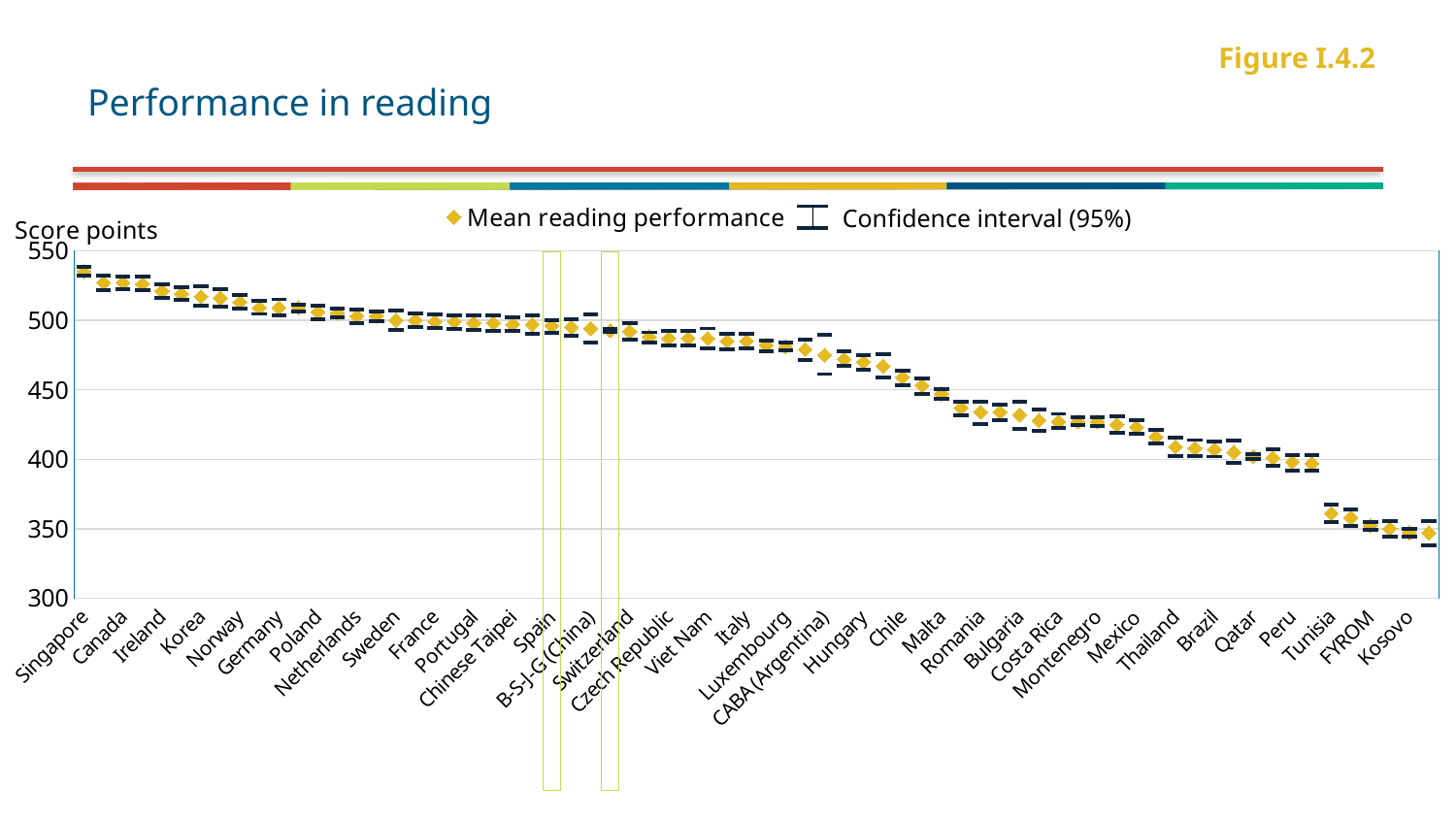
Which has a higher mean reading performance, Canada or Chile? Canada Which country has the highest mean reading performance? Singapore Is the mean reading performance for Kosovo greater or less than 400? less How many entries does the legend list? 2 Which country has the lowest mean reading performance? Kosovo What is the label on the vertical axis? Score points What is the title of the chart? Performance in reading What kind of chart is shown on the slide? scatter chart Do the mean reading performance values rise or fall from left to right along the x axis? fall Is the mean reading performance for Hungary greater or less than 450? greater Is the mean reading performance for Mexico greater or less than 450? less